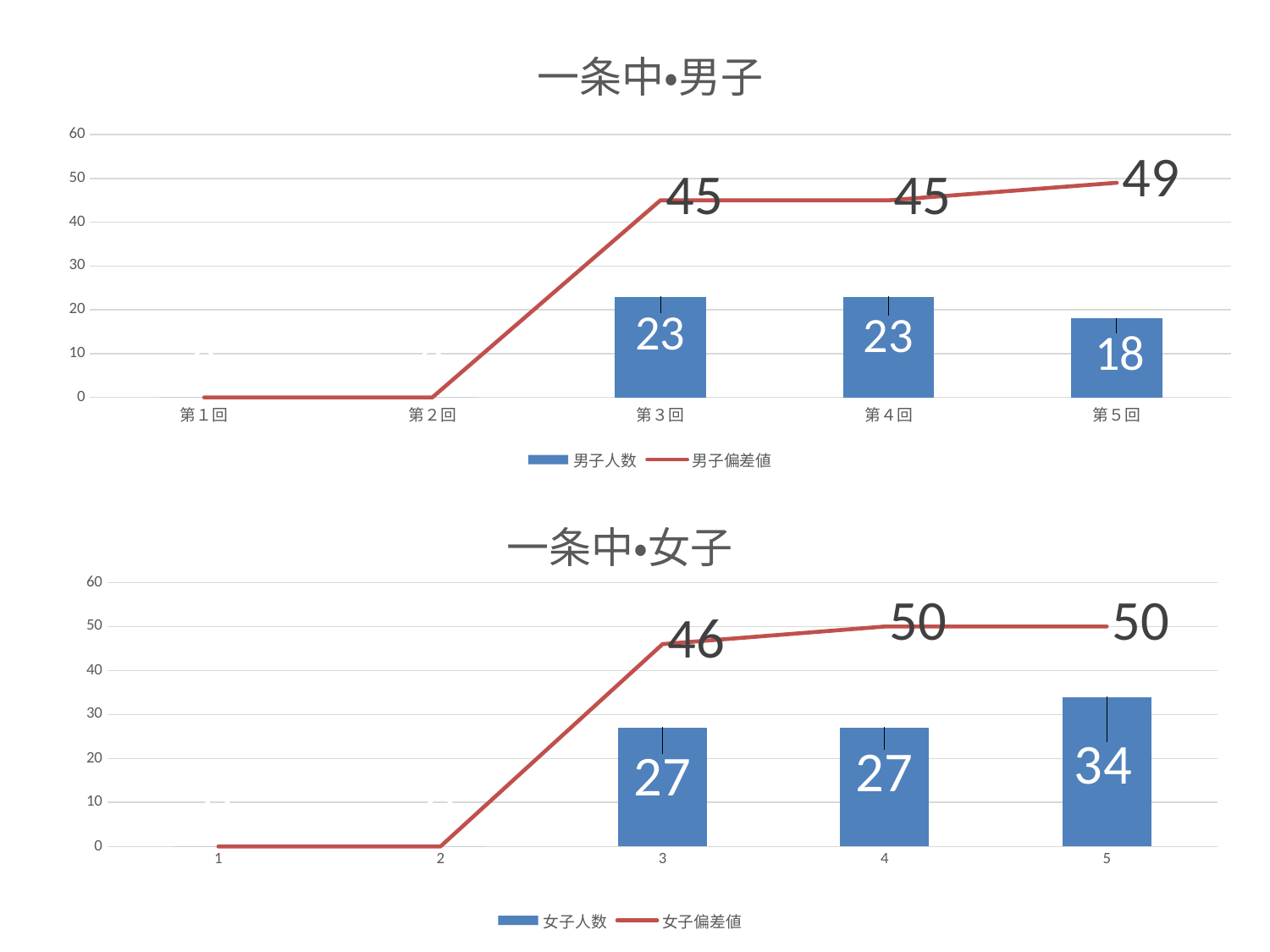
In the 一条中•女子 chart, what colour is the 女子偏差値 line? Red In the 一条中•女子 chart, what is the 女子偏差値 value for category 3? 46 In the 一条中•男子 chart, what is the 男子偏差値 value for 第５回? 49 In the 一条中•女子 chart, what is the 女子人数 value for category 5? 34 In the 一条中•女子 chart, is the 女子人数 for category 5 greater or less than 30? greater In the 一条中•男子 chart, how many categories are shown on the x axis? 5 In the 一条中•男子 chart, how many series does the legend list? 2 In the 一条中•女子 chart, which category has the highest 女子人数? 5 In the 一条中•男子 chart, what is the 男子人数 value for 第３回? 23 In the 一条中•男子 chart, what is the difference between the 男子偏差値 for 第５回 and 第４回? 4 In the 一条中•女子 chart, what is the difference between the 女子人数 for category 5 and category 4? 7